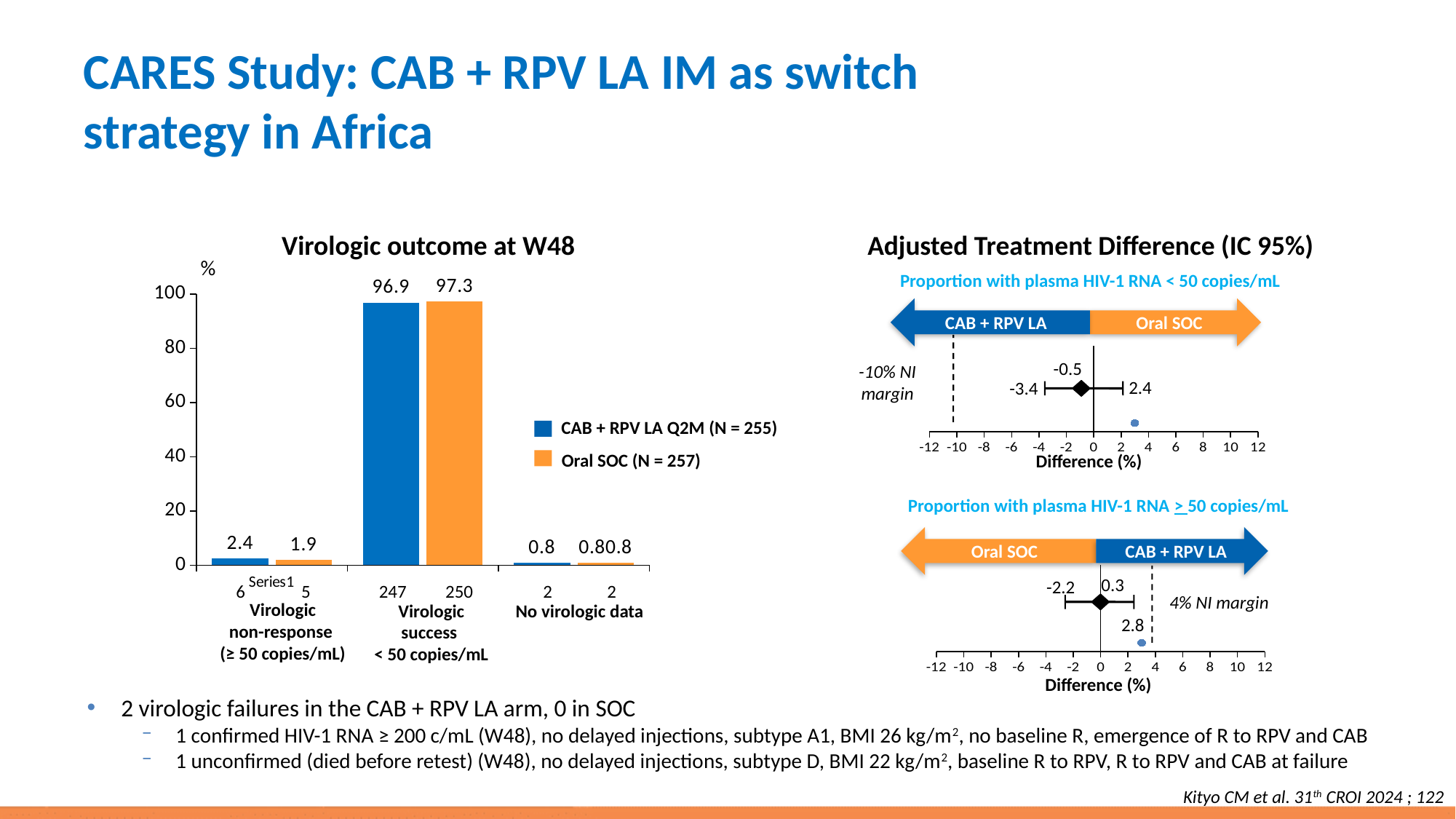
In the 'Virologic outcome at W48' chart, what is the value for CAB + RPV LA Q2M in the No virologic data category? 0.8 In the 'Virologic outcome at W48' chart, which series has the larger value for Virologic non-response? CAB + RPV LA Q2M (N = 255) In the 'Virologic outcome at W48' chart, what is the difference between the Oral SOC and CAB + RPV LA Q2M values for Virologic success? 0.4 In the 'Virologic outcome at W48' chart, what is the value for Oral SOC in the Virologic success (< 50 copies/mL) category? 97.3 What type of chart is 'Virologic outcome at W48'? Bar chart In the 'Adjusted Treatment Difference (IC 95%)' panel, what is the point estimate of the difference for the proportion with plasma HIV-1 RNA < 50 copies/mL? -0.5 In the 'Virologic outcome at W48' chart, what is the value for Oral SOC in the Virologic non-response (≥ 50 copies/mL) category? 1.9 In the 'Virologic outcome at W48' chart, what is the value for CAB + RPV LA Q2M in the Virologic non-response (≥ 50 copies/mL) category? 2.4 How many series does the legend of the 'Virologic outcome at W48' chart list? 2 In the 'Virologic outcome at W48' chart, which category has the highest values for both series? Virologic success < 50 copies/mL In the 'Virologic outcome at W48' chart, what is the value for CAB + RPV LA Q2M in the Virologic success (< 50 copies/mL) category? 96.9 In the 'Adjusted Treatment Difference (IC 95%)' panel, what is the upper confidence limit for the proportion with plasma HIV-1 RNA ≥ 50 copies/mL? 2.8